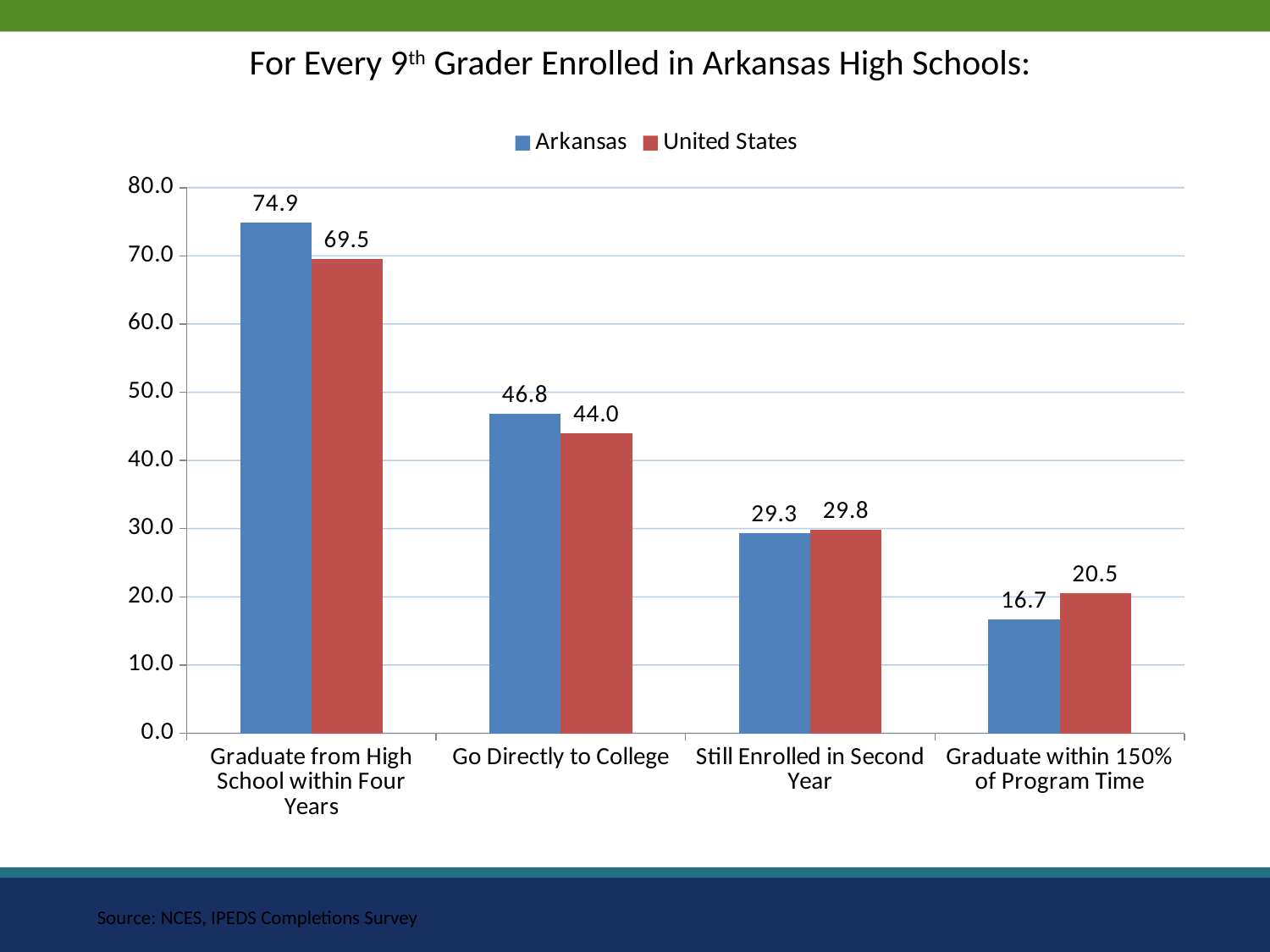
What is the difference between the United States and Arkansas values for Graduate within 150% of Program Time? 3.8 What is the Arkansas value for Graduate from High School within Four Years? 74.9 What is the Arkansas value for Graduate within 150% of Program Time? 16.7 What kind of chart is shown on the slide? Bar chart How many categories are shown on the x axis? 4 How many series does the legend list? 2 Which category has the lowest Arkansas value? Graduate within 150% of Program Time Which category has the highest United States value? Graduate from High School within Four Years What is the difference between the Arkansas and United States values for Graduate from High School within Four Years? 5.4 Do the Arkansas values rise or fall from left to right across the categories? Fall What is the United States value for Go Directly to College? 44.0 For Go Directly to College, which is larger: Arkansas or United States? Arkansas